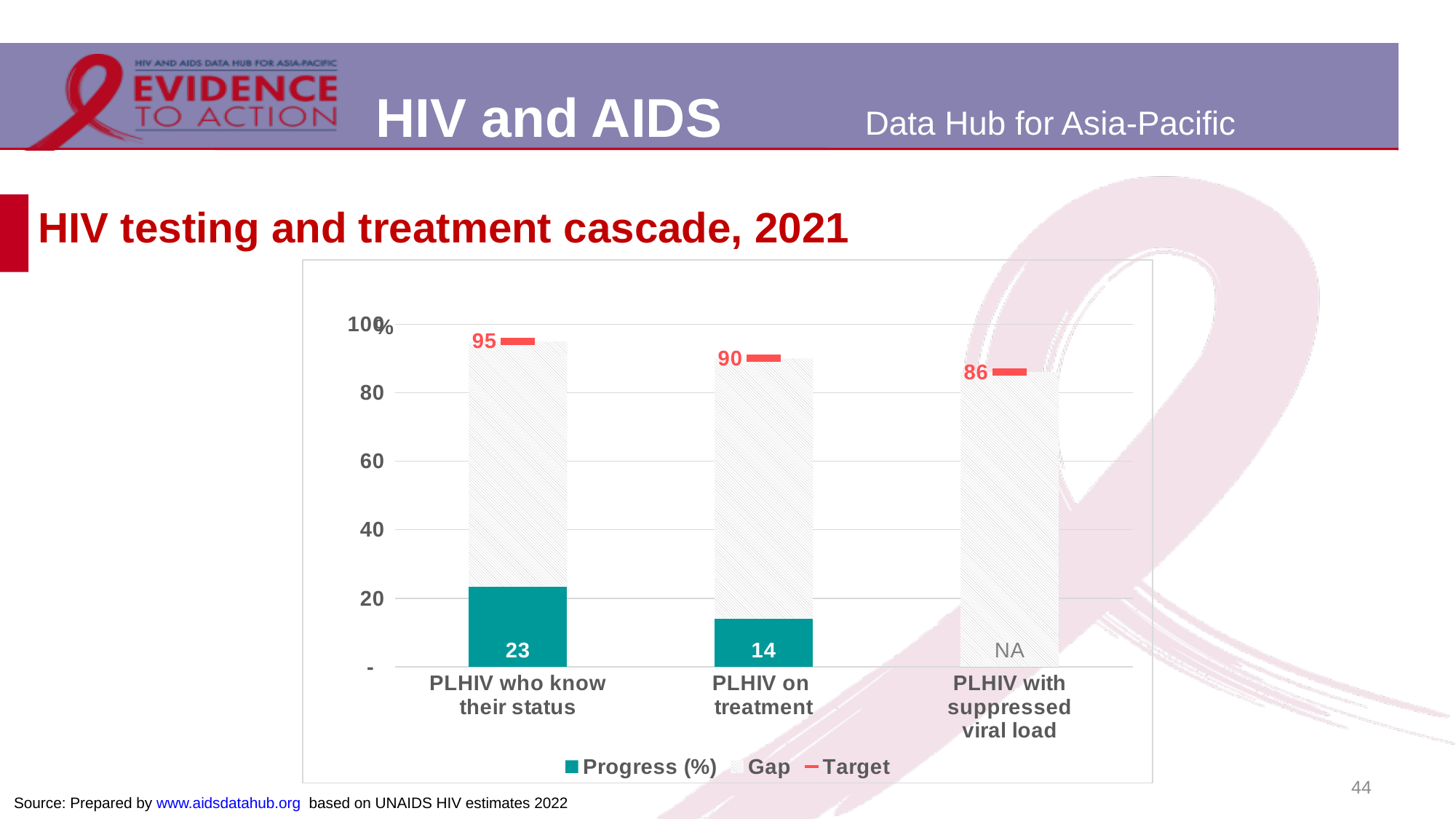
What is the Progress (%) value for PLHIV on treatment? 14 What is the Target value for PLHIV on treatment? 90 What is shown as the Progress value for PLHIV with suppressed viral load? NA What is the difference between the Target and the Progress (%) value for PLHIV who know their status? 72 What is the Progress (%) value for PLHIV who know their status? 23 Which category has the lowest Target value? PLHIV with suppressed viral load What kind of chart is shown on the slide? Bar chart Which category has the highest Target value? PLHIV who know their status What is the Target value for PLHIV who know their status? 95 What is the Target value for PLHIV with suppressed viral load? 86 Which is larger, the Progress (%) value for PLHIV who know their status or for PLHIV on treatment? PLHIV who know their status How many series does the legend list? 3